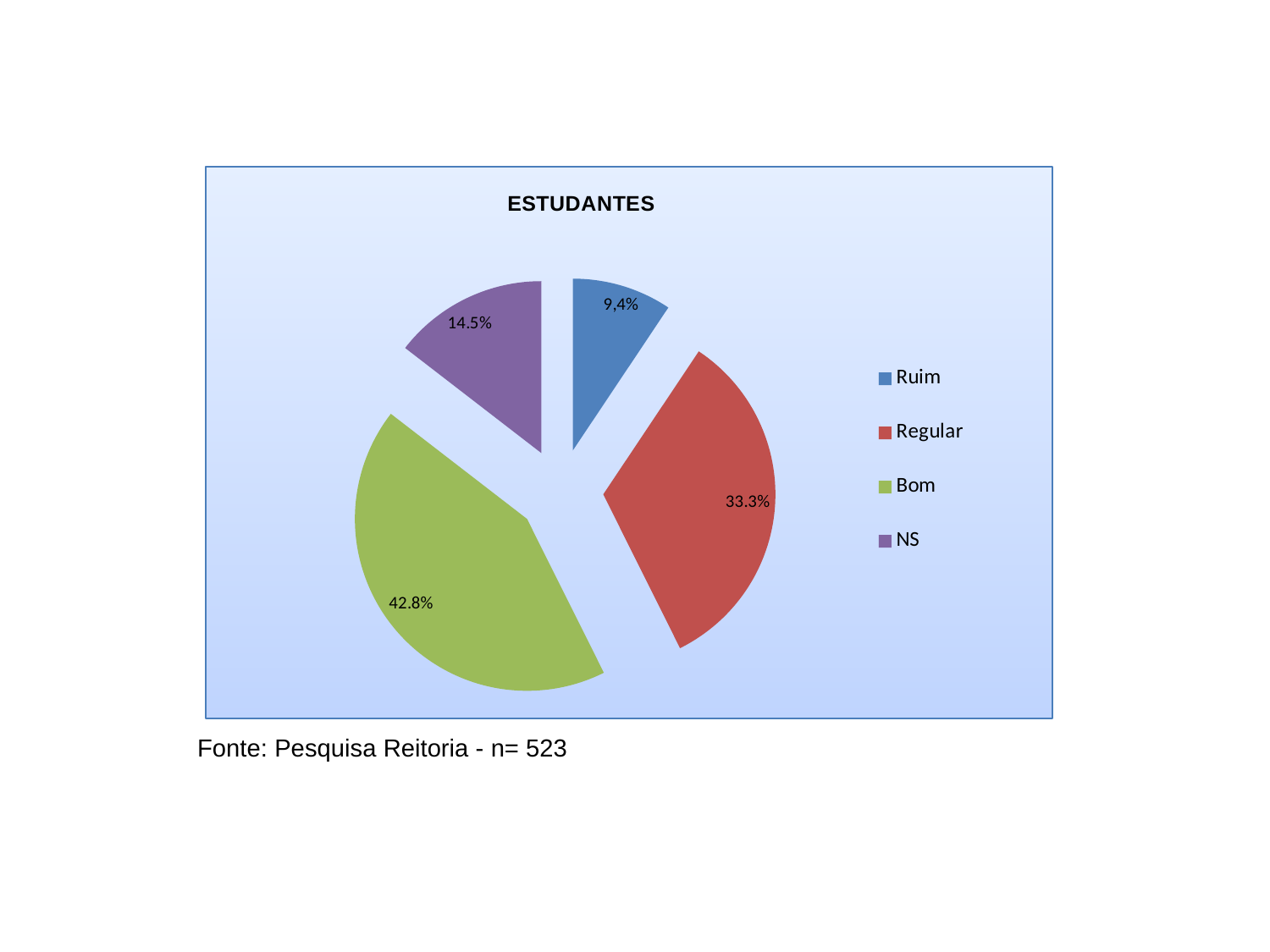
Which slice is larger, Regular or NS? Regular What percentage of the pie is labelled for Ruim? 9,4% What percentage of the pie is labelled for Regular? 33.3% What percentage of the pie is labelled for NS? 14.5% What percentage of the pie is labelled for Bom? 42.8% What kind of chart is shown on the slide? pie chart How many slices does the pie chart have? 4 Which category has the largest slice of the pie? Bom Which category has the smallest slice of the pie? Ruim What colour is the Bom slice? green How many entries does the legend list? 4 What is the title of the chart? ESTUDANTES